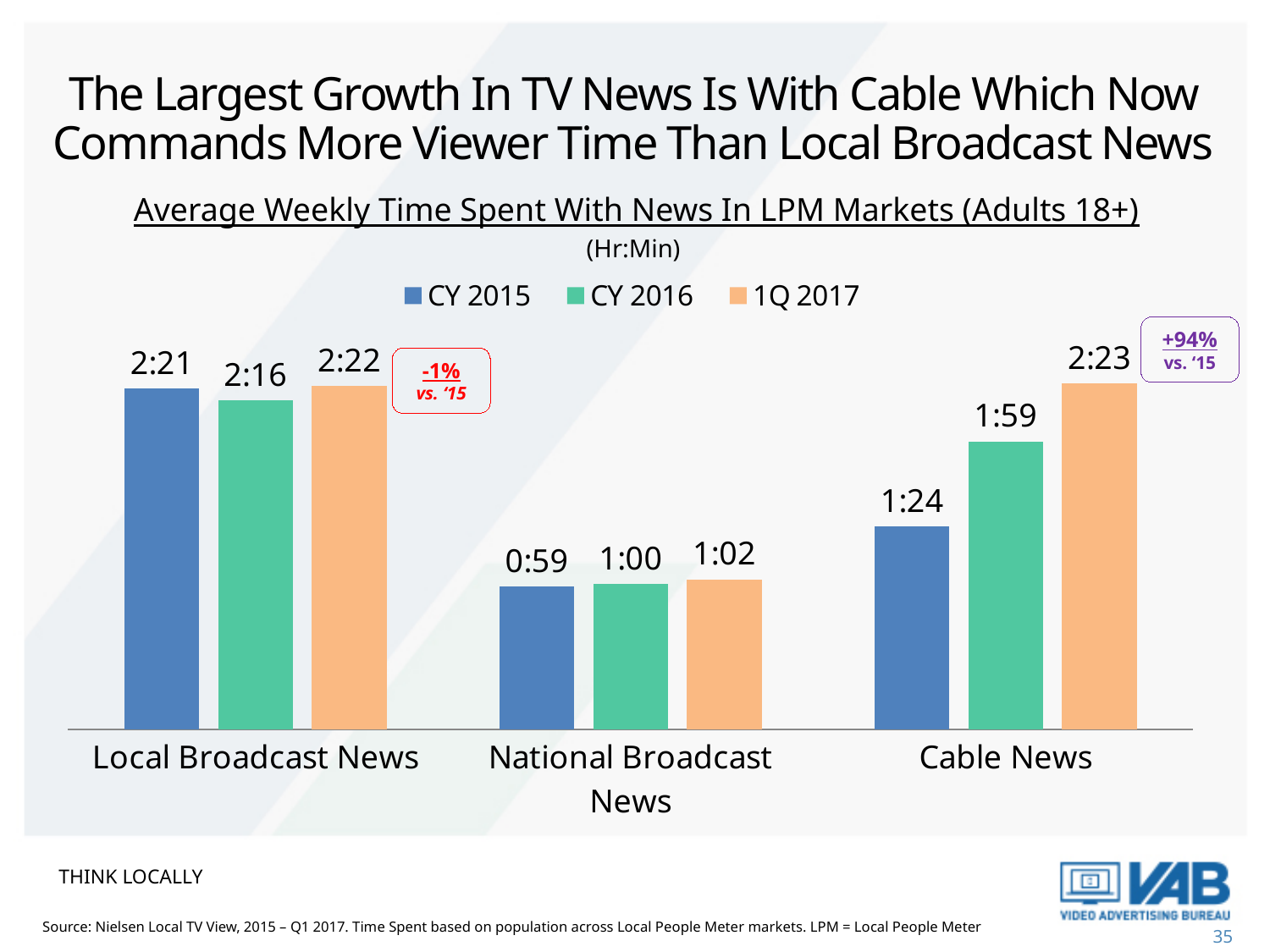
What kind of chart is shown on the slide? Bar chart Which category has the lowest value in 1Q 2017? National Broadcast News Do the values for Cable News rise or fall from CY 2015 to 1Q 2017? Rise What is the average weekly time spent with Local Broadcast News in CY 2015? 2:21 What is the average weekly time spent with National Broadcast News in CY 2016? 1:00 What is the average weekly time spent with Cable News in CY 2015? 1:24 What is the average weekly time spent with Cable News in 1Q 2017? 2:23 How many series does the legend list? 3 Which category has the highest value in CY 2015? Local Broadcast News Which is larger for CY 2016: Local Broadcast News or Cable News? Local Broadcast News How many categories are shown on the x axis? 3 What percentage change vs. '15 is annotated for Cable News? +94%